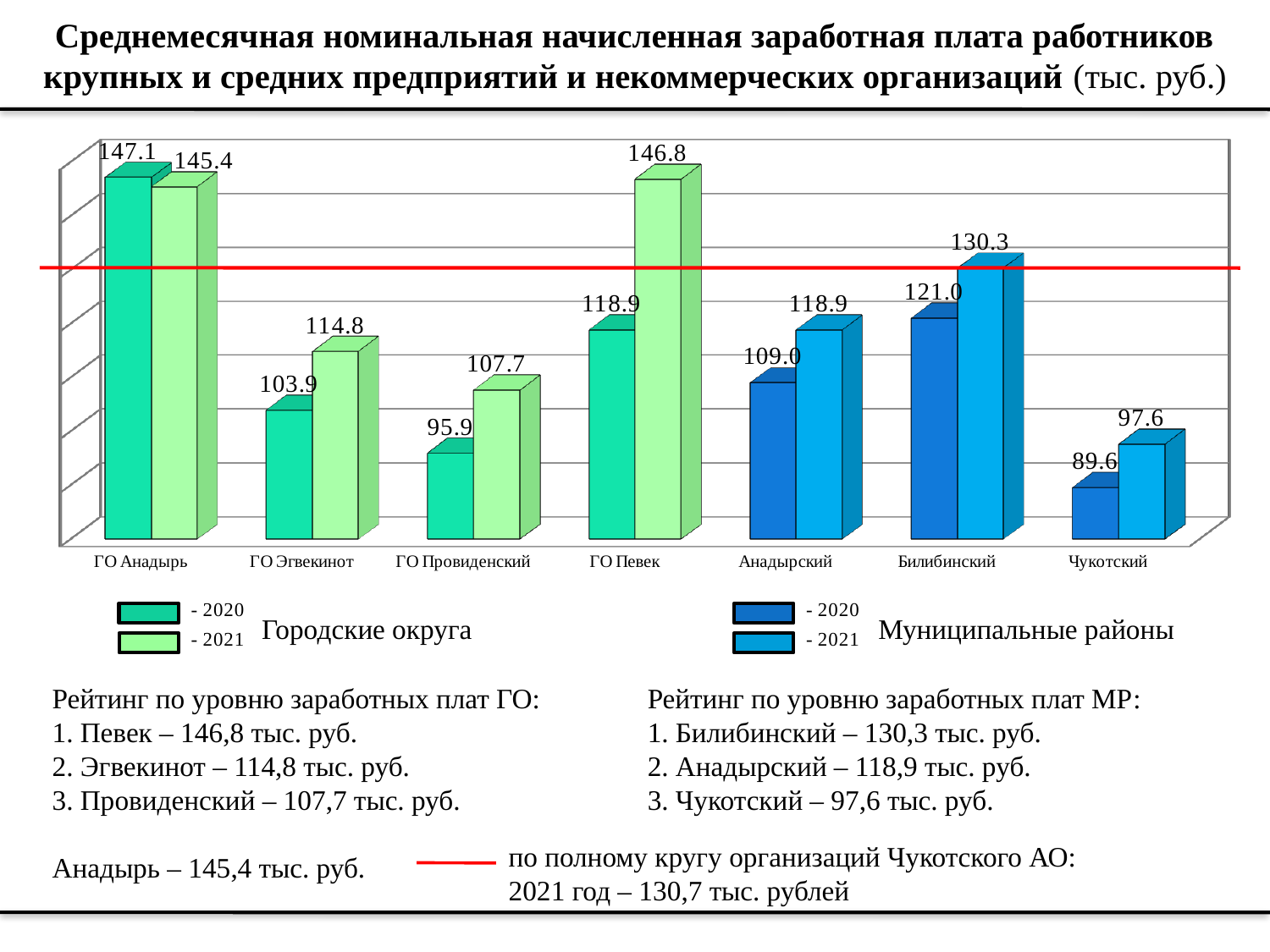
Which category has the lowest 2021 value? Чукотский How many categories are shown on the x axis of the chart? 7 What is the 2021 value for Чукотский? 97.6 Which category has the highest 2020 value? ГО Анадырь What is the 2020 value for Билибинский? 121.0 What is the 2021 value for ГО Певек? 146.8 What is the difference between the 2021 and 2020 values for ГО Певек? 27.9 What kind of chart is shown on the slide? bar chart What value does the red horizontal line on the chart represent, according to the slide text? 130,7 тыс. рублей Which is larger for ГО Анадырь: the 2020 value or the 2021 value? 2020 Which is larger: the 2021 value for ГО Эгвекинот or the 2021 value for ГО Провиденский? ГО Эгвекинот What is the difference between the 2021 values for Билибинский and Анадырский? 11.4